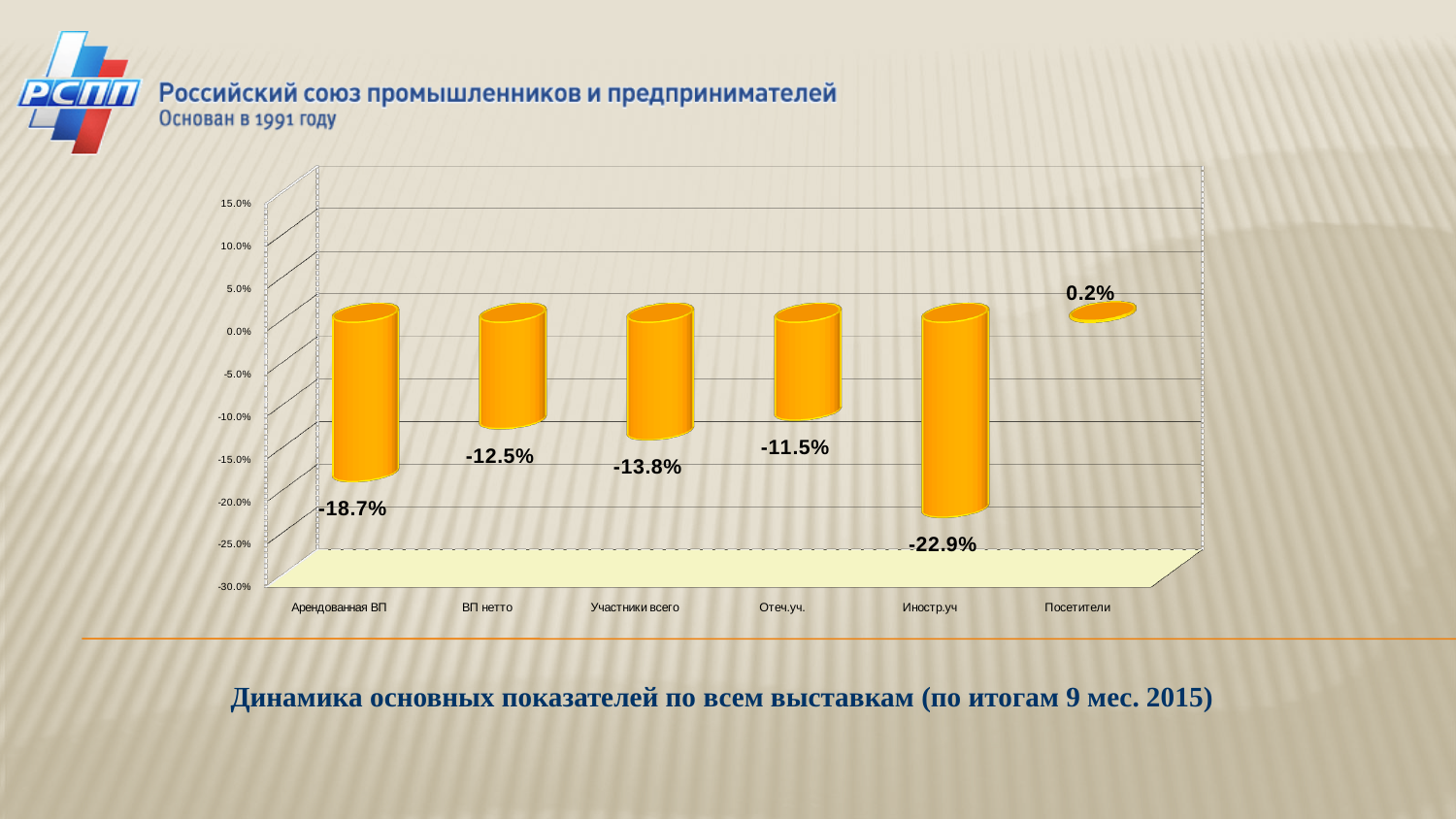
What is the difference between the values for Арендованная ВП and ВП нетто? 6.2 percentage points What is the value for Арендованная ВП? -18.7% What is the value for Отеч.уч.? -11.5% What is the value for Участники всего? -13.8% How many categories are shown on the chart? 6 Which is larger, the value for Отеч.уч. or the value for Участники всего? Отеч.уч. What is the value for Иностр.уч? -22.9% What is the value for ВП нетто? -12.5% What is the value for Посетители? 0.2% Which category has the highest value? Посетители What kind of chart is shown on the slide? Bar chart Which category has the lowest value? Иностр.уч